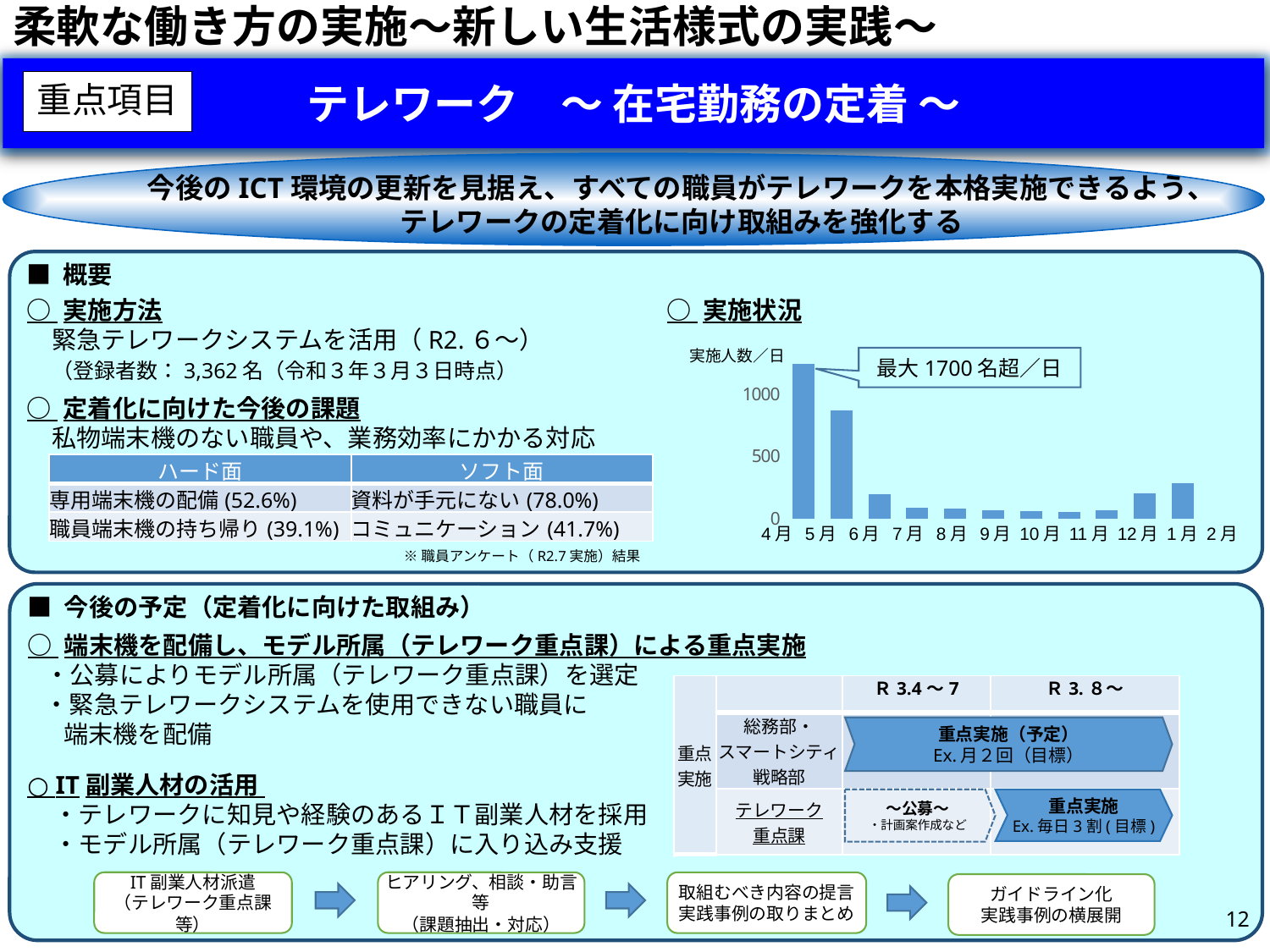
In the 実施状況 chart, is the value for 1月 greater or less than 500? less In the 実施状況 chart, is the value for 6月 greater or less than 500? less What is the y-axis label of the 実施状況 chart? 実施人数／日 What kind of chart is shown under 実施状況? bar chart In the 実施状況 chart, which is larger, the value for 4月 or the value for 5月? 4月 Which month has the highest bar in the 実施状況 chart? 4月 In the 実施状況 chart, is the value for 5月 greater or less than 500? greater How many months are shown on the x axis of the 実施状況 chart? 11 In the 実施状況 chart, do the values rise or fall from 4月 to 7月? fall In the 実施状況 chart, which is larger, the value for 5月 or the value for 1月? 5月